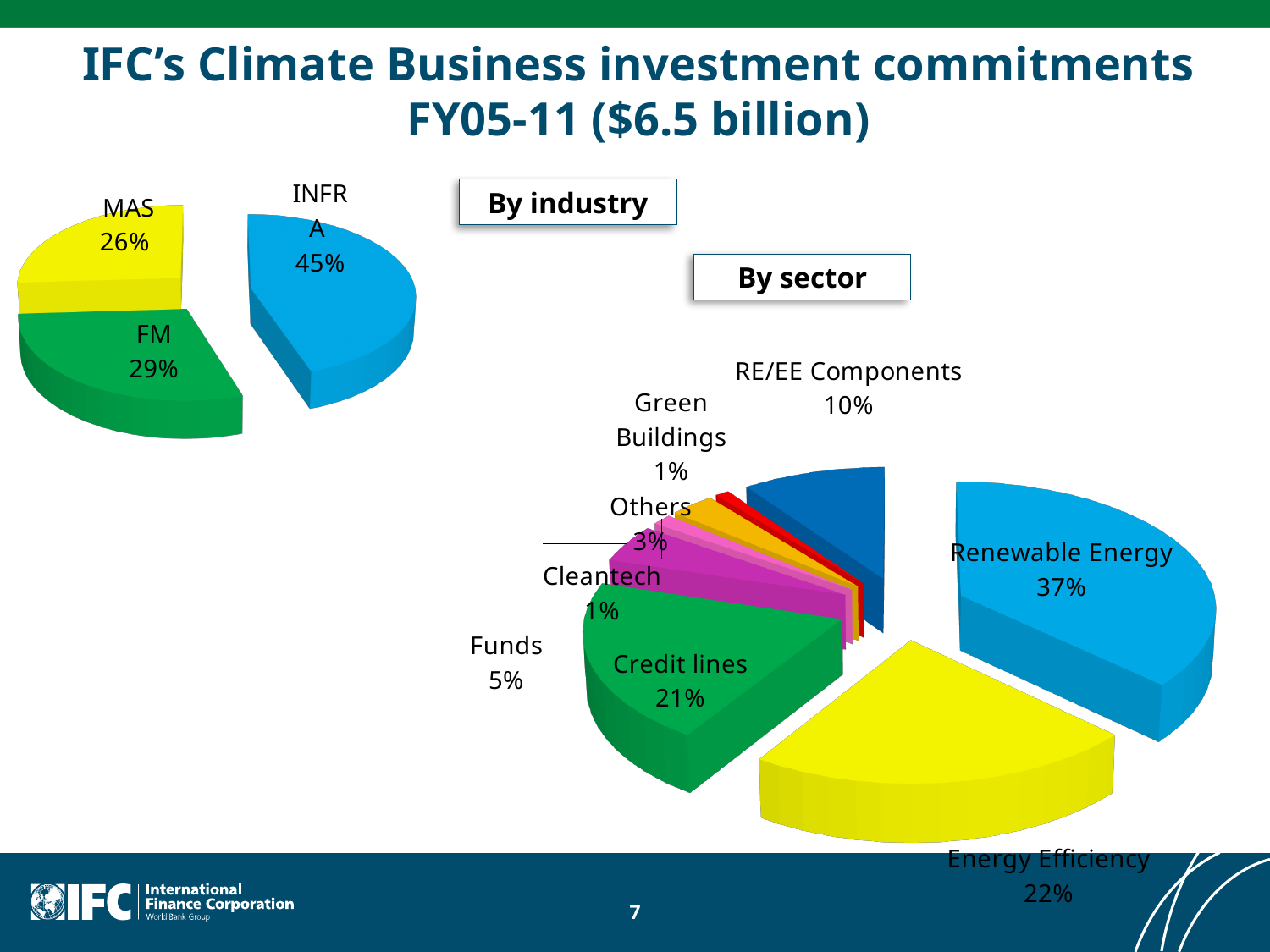
What type of chart is used for the 'By sector' breakdown? Pie chart In the 'By sector' pie chart, what share does RE/EE Components have? 10% In the 'By industry' pie chart, how many slices are there? 3 In the 'By sector' pie chart, what share do Credit lines have? 21% In the 'By sector' pie chart, which sector has the largest share? Renewable Energy In the 'By sector' pie chart, what share does Renewable Energy have? 37% In the 'By sector' pie chart, how many sectors are shown? 8 In the 'By industry' pie chart, which category has the smallest share? MAS In the 'By industry' pie chart, what share does FM have? 29% In the 'By industry' pie chart, what share does INFRA have? 45% In the 'By industry' pie chart, what is the difference between the INFRA and MAS shares? 19% In the 'By sector' pie chart, which is larger, Energy Efficiency or Funds? Energy Efficiency